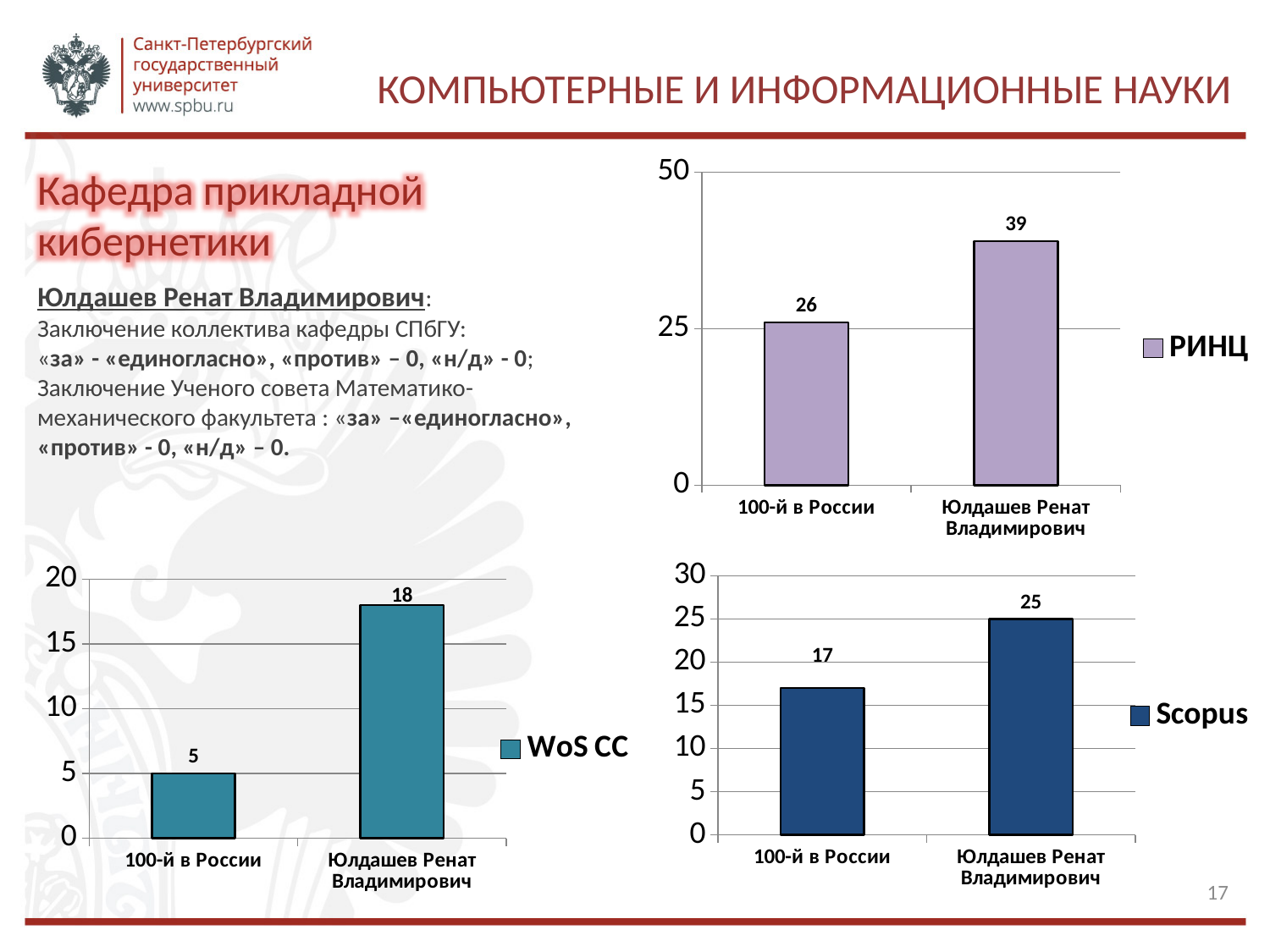
In the WoS CC chart (bottom left), what is the value for Юлдашев Ренат Владимирович? 18 In the WoS CC chart (bottom left), what is the value for 100-й в России? 5 How many categories are shown in the РИНЦ chart (top right)? 2 What kind of chart is the WoS CC chart (bottom left)? Bar chart In the Scopus chart (bottom right), what is the value for Юлдашев Ренат Владимирович? 25 In the Scopus chart (bottom right), which category has the lowest value? 100-й в России In the РИНЦ chart (top right), what is the value for Юлдашев Ренат Владимирович? 39 In the Scopus chart (bottom right), what is the difference between the two bars? 8 In the РИНЦ chart (top right), what is the value for 100-й в России? 26 In the РИНЦ chart (top right), what is the difference between the value for Юлдашев Ренат Владимирович and the value for 100-й в России? 13 In the WoS CC chart (bottom left), which category has the highest value? Юлдашев Ренат Владимирович In the Scopus chart (bottom right), what is the value for 100-й в России? 17